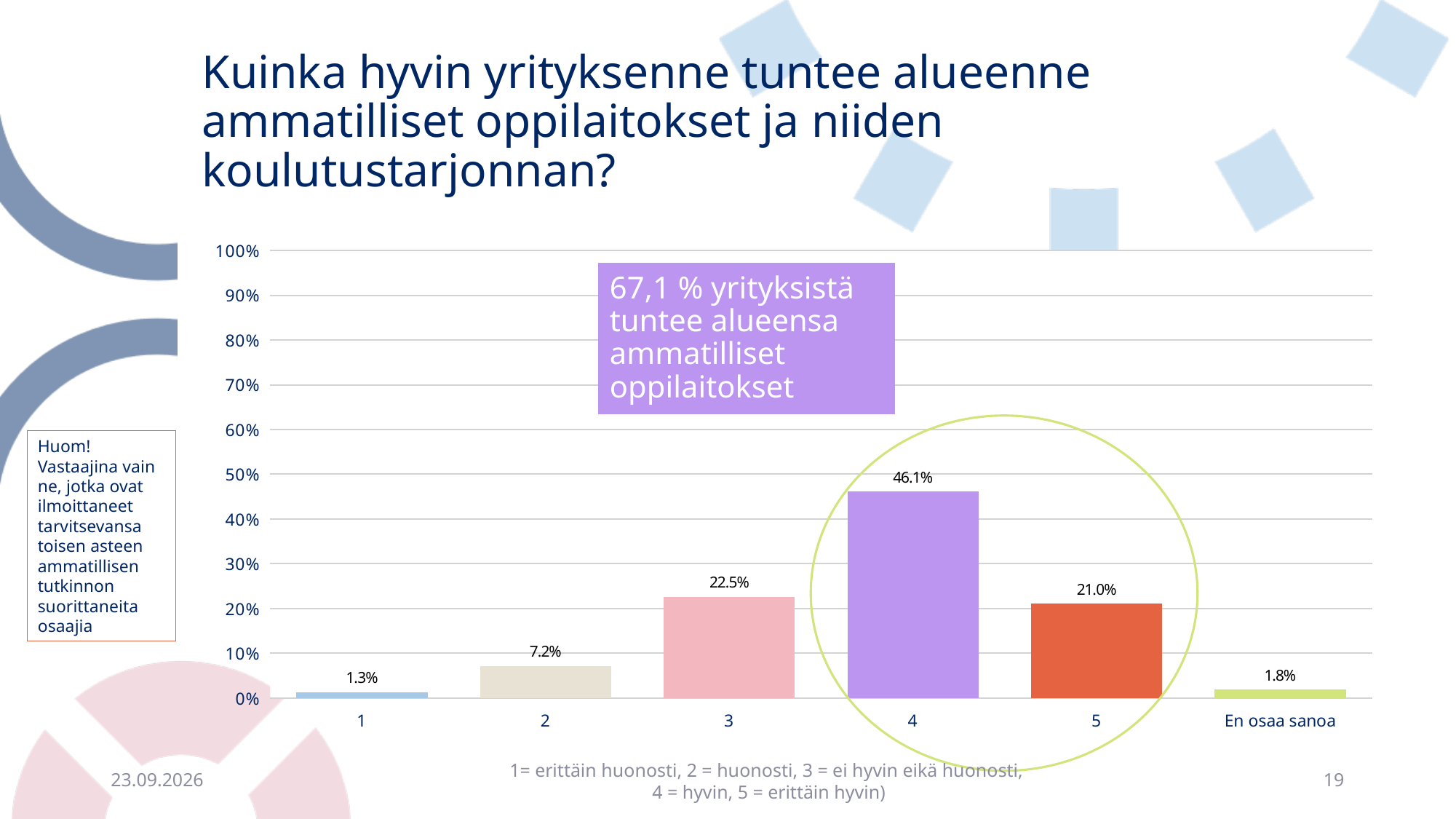
Which category has the lowest value? 1 What kind of chart is shown on the slide? bar chart What is the value for "En osaa sanoa"? 1.8% What is the value for category 2? 7.2% Which category has the highest value? 4 What is the combined value of categories 4 and 5? 67.1% What is the difference between the values for category 4 and category 5? 25.1% What is the difference between the values for category 3 and category 2? 15.3% How many categories are shown on the x axis? 6 Which is larger, the value for category 3 or the value for category 5? 3 Is the value for category 4 greater or less than 40%? greater What is the value for category 4? 46.1%